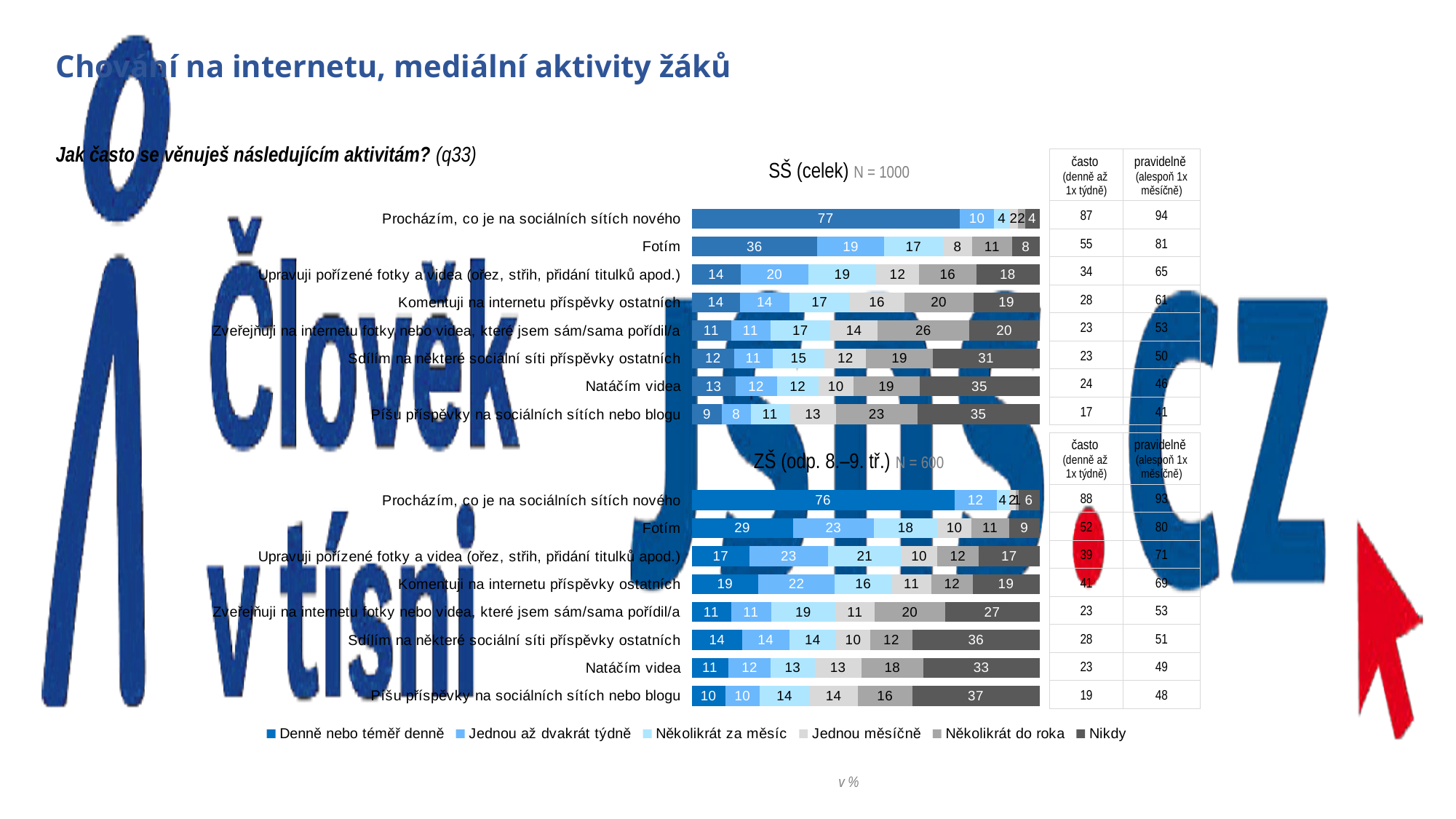
In the SŠ (celek) chart, what is the value of 'Denně nebo téměř denně' for 'Procházím, co je na sociálních sítích nového'? 77 In the SŠ (celek) chart, which activity has the lowest 'Denně nebo téměř denně' value? Píšu příspěvky na sociálních sítích nebo blogu What type of chart is used for the SŠ (celek) data? Stacked bar chart In the SŠ (celek) chart, what is the value of 'Nikdy' for 'Natáčím videa'? 35 In the SŠ (celek) chart, which activity has the highest 'Denně nebo téměř denně' value? Procházím, co je na sociálních sítích nového In the ZŠ (odp. 8.–9. tř.) chart, what is the difference between the 'Denně nebo téměř denně' values for 'Fotím' and 'Komentuji na internetu příspěvky ostatních'? 10 What is the sample size (N) shown in the title of the ZŠ (odp. 8.–9. tř.) chart? N = 600 How many series does the legend list? 6 In the SŠ (celek) chart, which is larger: the 'Nikdy' value for 'Sdílím na některé sociální síti příspěvky ostatních' or for 'Komentuji na internetu příspěvky ostatních'? Sdílím na některé sociální síti příspěvky ostatních How many activities (categories) are shown in the ZŠ (odp. 8.–9. tř.) chart? 8 In the ZŠ (odp. 8.–9. tř.) chart, what is the value of 'Nikdy' for 'Píšu příspěvky na sociálních sítích nebo blogu'? 37 In the ZŠ (odp. 8.–9. tř.) chart, what is the value of 'Jednou až dvakrát týdně' for 'Fotím'? 23